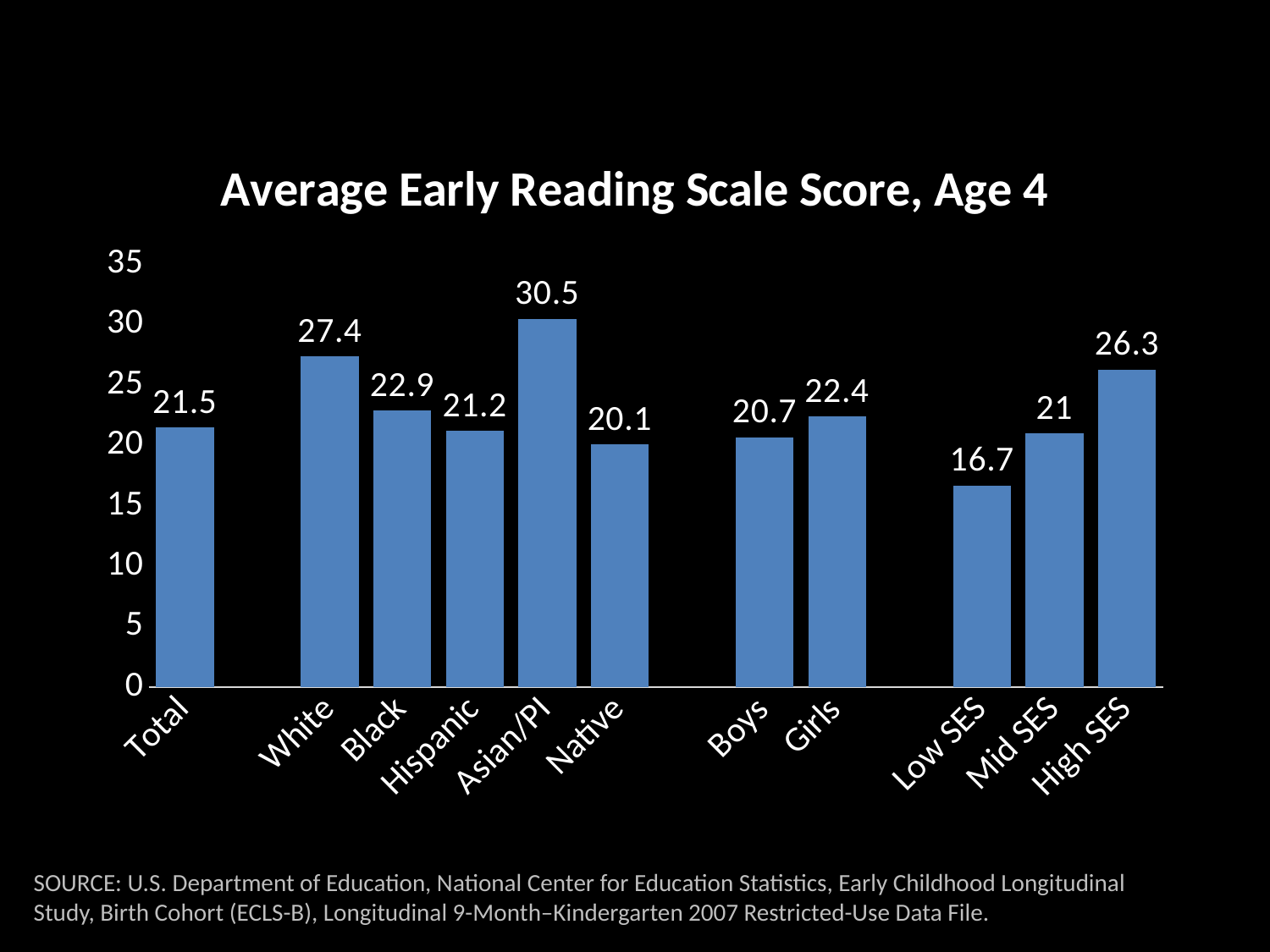
Which category has the highest average early reading scale score? Asian/PI What is the average early reading scale score for the Low SES group? 16.7 How many categories are shown on the x axis? 11 What is the value shown for Girls? 22.4 What is the difference between the scores for High SES and Low SES? 9.6 What is the difference between the scores for White and Black children? 4.5 What kind of chart is shown on the slide? bar chart Which has a higher score, Boys or Girls? Girls Is the value for Native greater or less than 25? less What is the title of the chart? Average Early Reading Scale Score, Age 4 What is the average early reading scale score for Asian/PI children? 30.5 Which category has the lowest average early reading scale score? Low SES